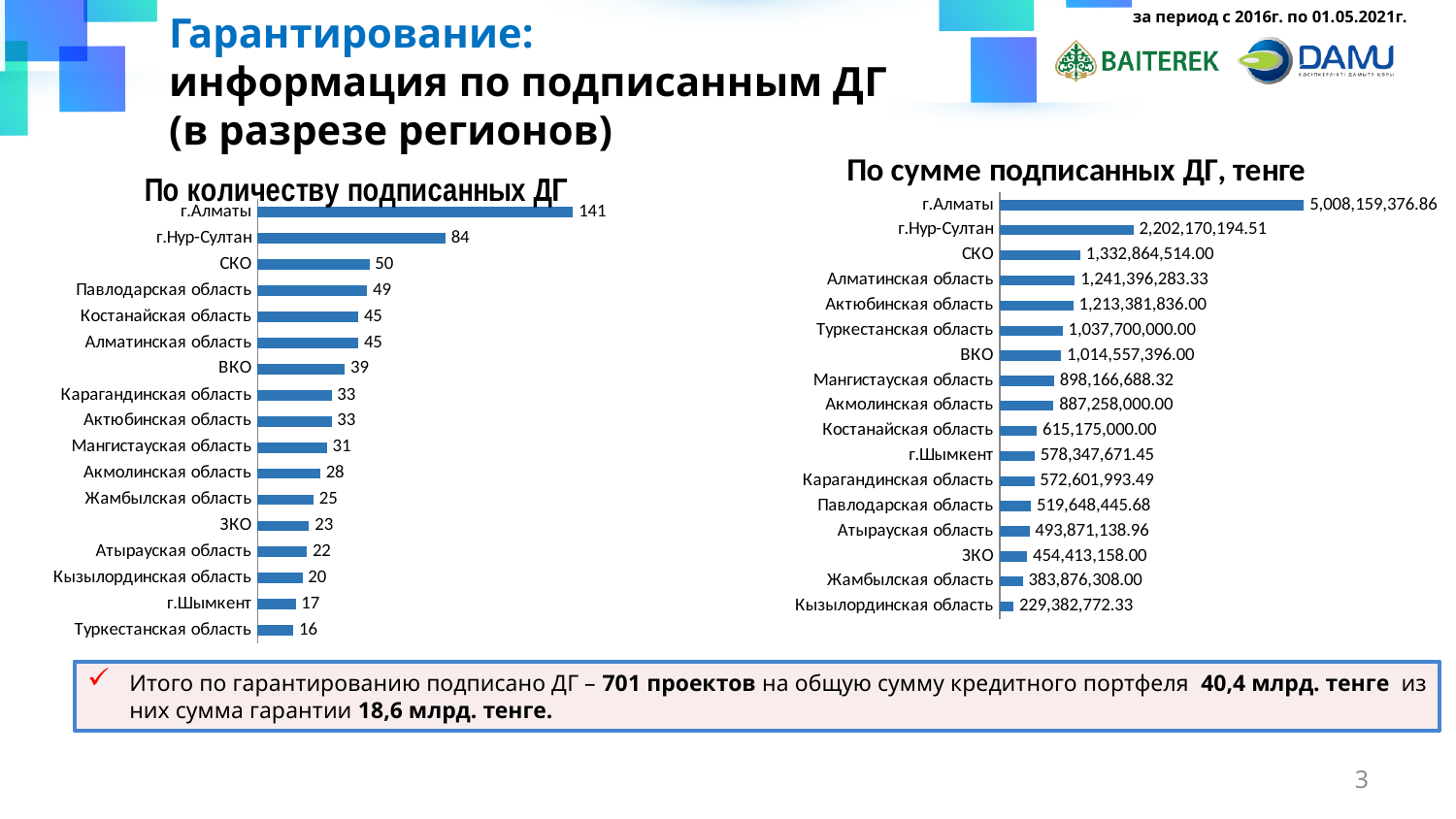
In the chart "По количеству подписанных ДГ", which region has the highest value? г.Алматы In the chart "По количеству подписанных ДГ", what is the difference between г.Алматы and г.Нур-Султан? 57 What type of chart is "По сумме подписанных ДГ, тенге"? Bar chart In the chart "По количеству подписанных ДГ", which region has the lowest value? Туркестанская область In the chart "По сумме подписанных ДГ, тенге", which is larger: Туркестанская область or ВКО? Туркестанская область In the chart "По количеству подписанных ДГ", which is larger: Павлодарская область or Костанайская область? Павлодарская область In the chart "По сумме подписанных ДГ, тенге", which region has the lowest value? Кызылординская область In the chart "По количеству подписанных ДГ", what is the value for г.Нур-Султан? 84 In the chart "По сумме подписанных ДГ, тенге", what is the value for г.Шымкент? 578,347,671.45 In the chart "По количеству подписанных ДГ", how many regions are shown? 17 In the chart "По количеству подписанных ДГ", what is the value for ЗКО? 23 In the chart "По сумме подписанных ДГ, тенге", what is the value for СКО? 1,332,864,514.00